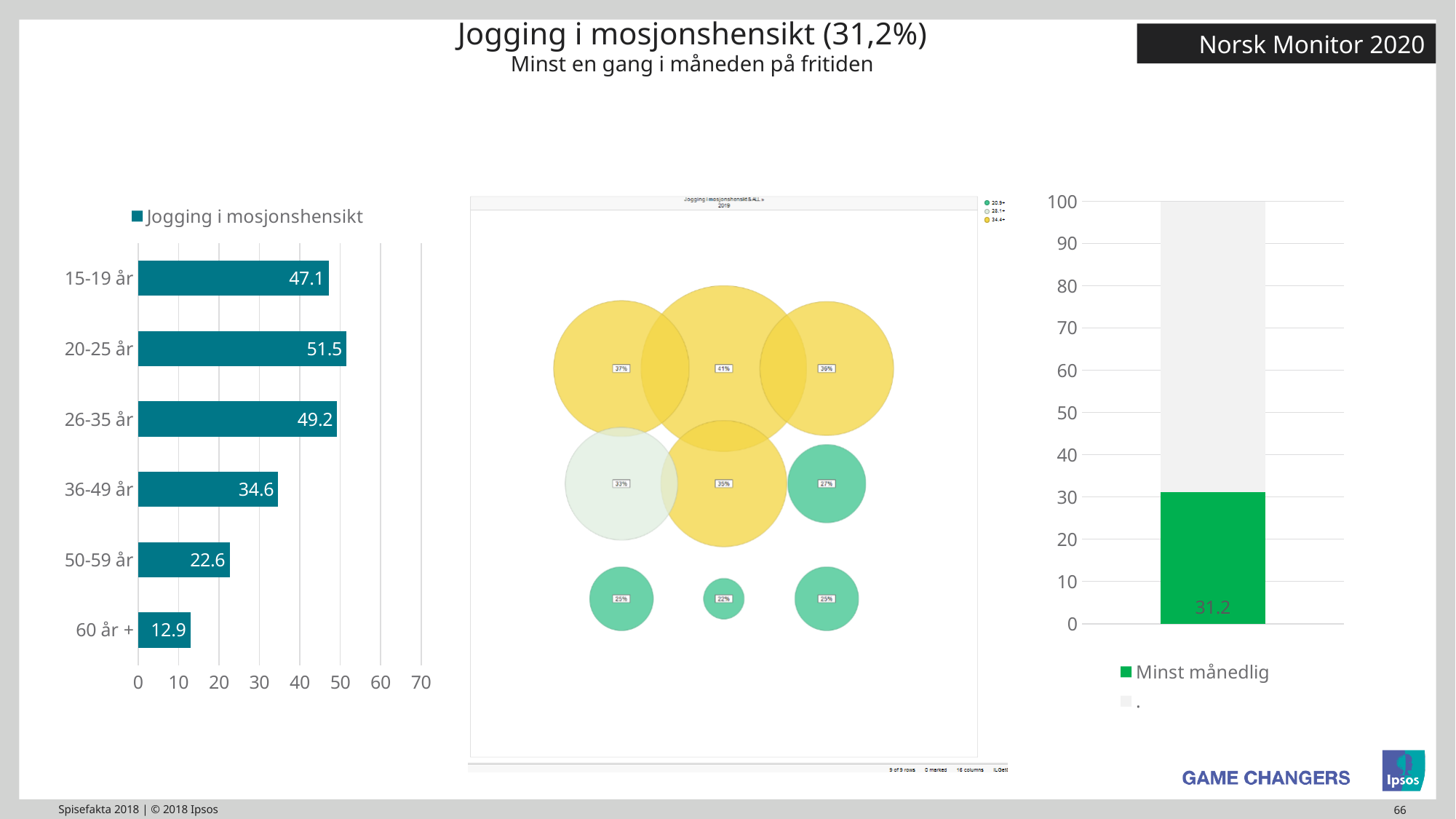
In the left bar chart, how many age groups are shown? 6 In the right-hand bar chart, is the value for 'Minst månedlig' greater or less than 40? less In the left bar chart, what is the value for the 60 år + age group? 12.9 In the left bar chart, which is larger: the value for 15-19 år or the value for 50-59 år? 15-19 år In the left bar chart, what is the difference between the values for 26-35 år and 36-49 år? 14.6 In the left bar chart, what is the name of the series shown in the legend? Jogging i mosjonshensikt In the right-hand bar chart, what is the value of the green 'Minst månedlig' segment? 31.2 In the left bar chart, which age group has the lowest value? 60 år + What kind of chart is the chart on the left of the slide? Bar chart In the left bar chart, is the value for 36-49 år greater or less than 30? greater In the left bar chart, what is the value for the 20-25 år age group? 51.5 In the left bar chart, which age group has the highest value? 20-25 år